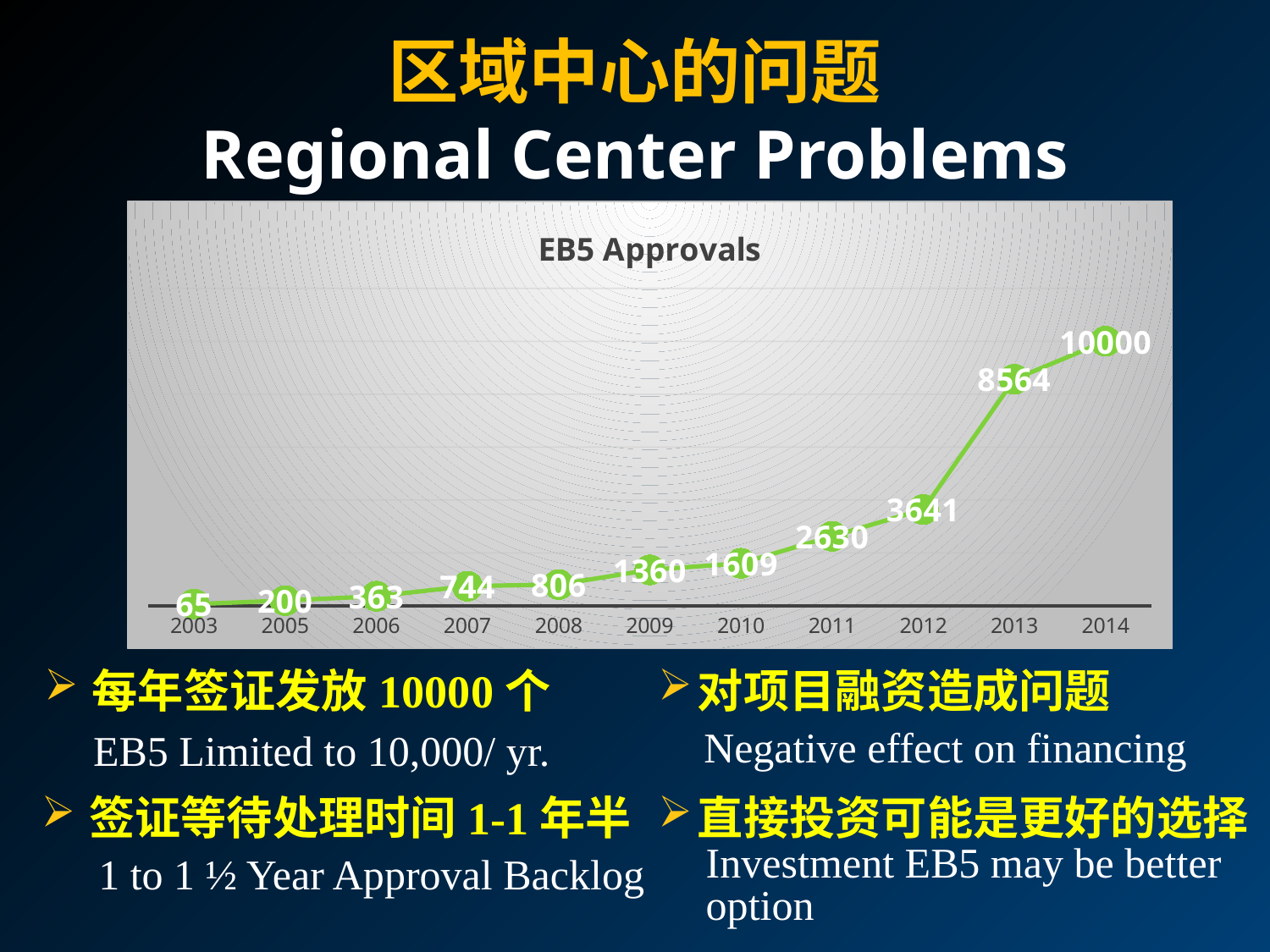
What is the value for 2014 in the EB5 Approvals chart? 10000 What is the difference between the values for 2014 and 2013 in the EB5 Approvals chart? 1436 What is the value for 2003 in the EB5 Approvals chart? 65 What is the value for 2012 in the EB5 Approvals chart? 3641 Which is larger in the EB5 Approvals chart, the value for 2011 or the value for 2010? 2011 Do the values in the EB5 Approvals chart rise or fall from 2003 to 2014? rise What is the value for 2009 in the EB5 Approvals chart? 1360 Which year has the lowest value in the EB5 Approvals chart? 2003 What kind of chart is the EB5 Approvals chart? line chart How many data points are plotted in the EB5 Approvals chart? 11 Which year has the highest value in the EB5 Approvals chart? 2014 What is the difference between the values for 2013 and 2012 in the EB5 Approvals chart? 4923